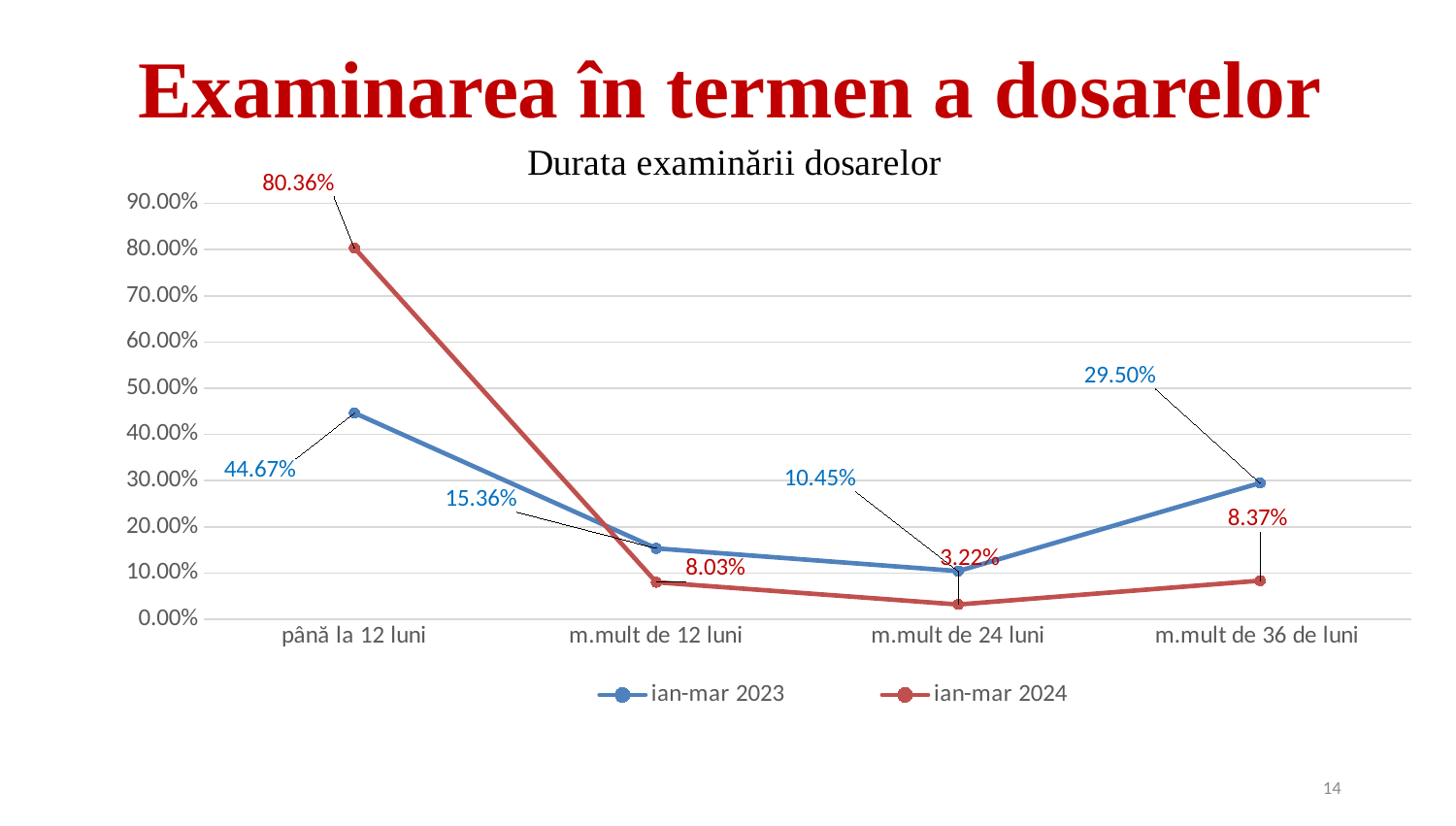
What is the value for ian-mar 2023 in the 'm.mult de 36 de luni' category? 29.50% What is the value for ian-mar 2024 in the 'm.mult de 24 luni' category? 3.22% What is the value for ian-mar 2023 in the 'm.mult de 12 luni' category? 15.36% Which category has the lowest value for the ian-mar 2024 series? m.mult de 24 luni Which category has the highest value for the ian-mar 2023 series? până la 12 luni In the 'm.mult de 12 luni' category, which series has the larger value, ian-mar 2023 or ian-mar 2024? ian-mar 2023 How many series does the legend list? 2 What type of chart is shown on the slide? line chart What is the difference between the ian-mar 2024 and ian-mar 2023 values in the 'până la 12 luni' category? 35.69% What is the value for ian-mar 2024 in the 'până la 12 luni' category? 80.36% How many categories are shown on the x axis? 4 What is the difference between the ian-mar 2023 and ian-mar 2024 values in the 'm.mult de 36 de luni' category? 21.13%